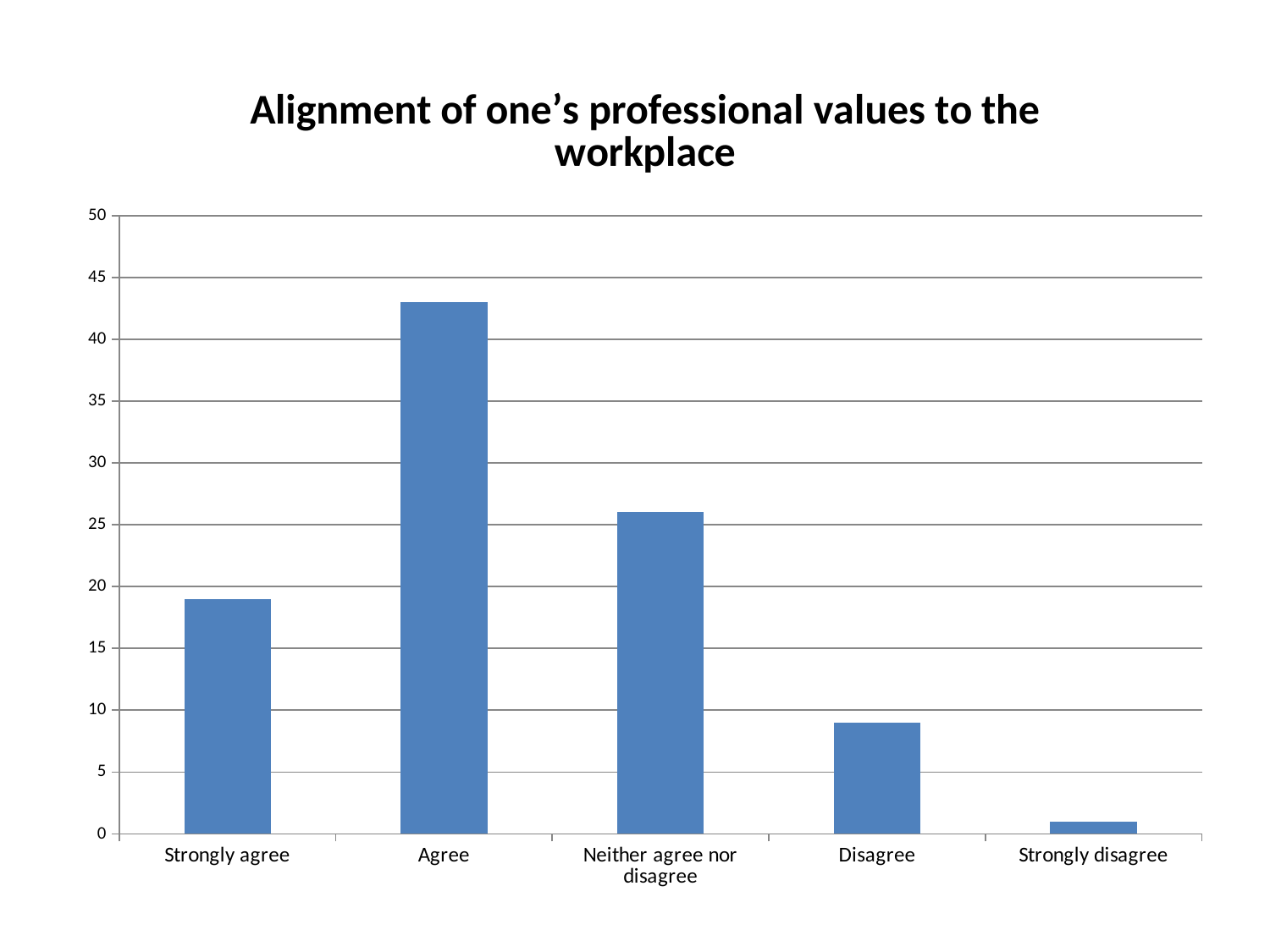
Which is larger, the value for Disagree or the value for Strongly agree? Strongly agree What is the title of the chart? Alignment of one's professional values to the workplace How many categories are shown on the x axis? 5 Is the value for Agree greater or less than 40? greater Which category has the highest value? Agree Is the value for Neither agree nor disagree greater or less than 25? greater Which category has the lowest value? Strongly disagree Is the value for Disagree greater or less than 10? less What kind of chart is shown on the slide? bar chart Which is larger, the value for Strongly agree or the value for Neither agree nor disagree? Neither agree nor disagree